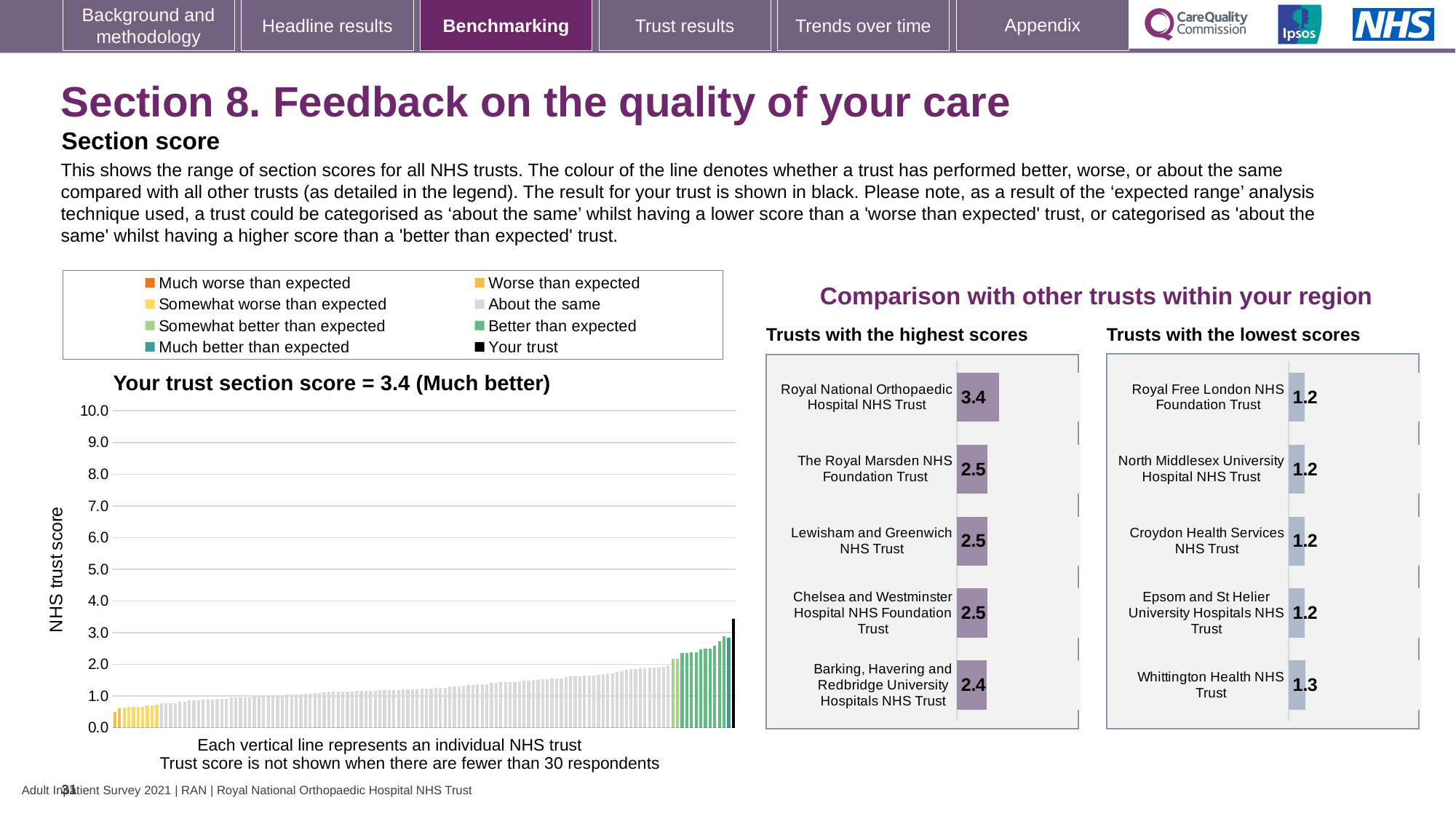
In the 'Trusts with the highest scores' chart, which trust has the highest score? Royal National Orthopaedic Hospital NHS Trust In the 'Your trust section score' chart, is the value for your trust (the black bar) greater or less than 3.0? greater In the 'Trusts with the highest scores' chart, what is the score for The Royal Marsden NHS Foundation Trust? 2.5 In the 'Trusts with the lowest scores' chart, which trust has the highest score? Whittington Health NHS Trust How many entries does the legend above the 'Your trust section score' chart list? 8 In the 'Your trust section score' chart, what is the label on the vertical axis? NHS trust score How many trusts are shown in the 'Trusts with the lowest scores' chart? 5 In the 'Trusts with the highest scores' chart, what is the difference between the scores of Royal National Orthopaedic Hospital NHS Trust and Barking, Havering and Redbridge University Hospitals NHS Trust? 1.0 In the 'Your trust section score' chart, what kind of chart is shown? bar chart In the 'Your trust section score' chart, what is the section score for your trust? 3.4 In the 'Your trust section score' chart, do the bar heights rise or fall from left to right? rise In the 'Trusts with the lowest scores' chart, which has the larger score: Whittington Health NHS Trust or Croydon Health Services NHS Trust? Whittington Health NHS Trust